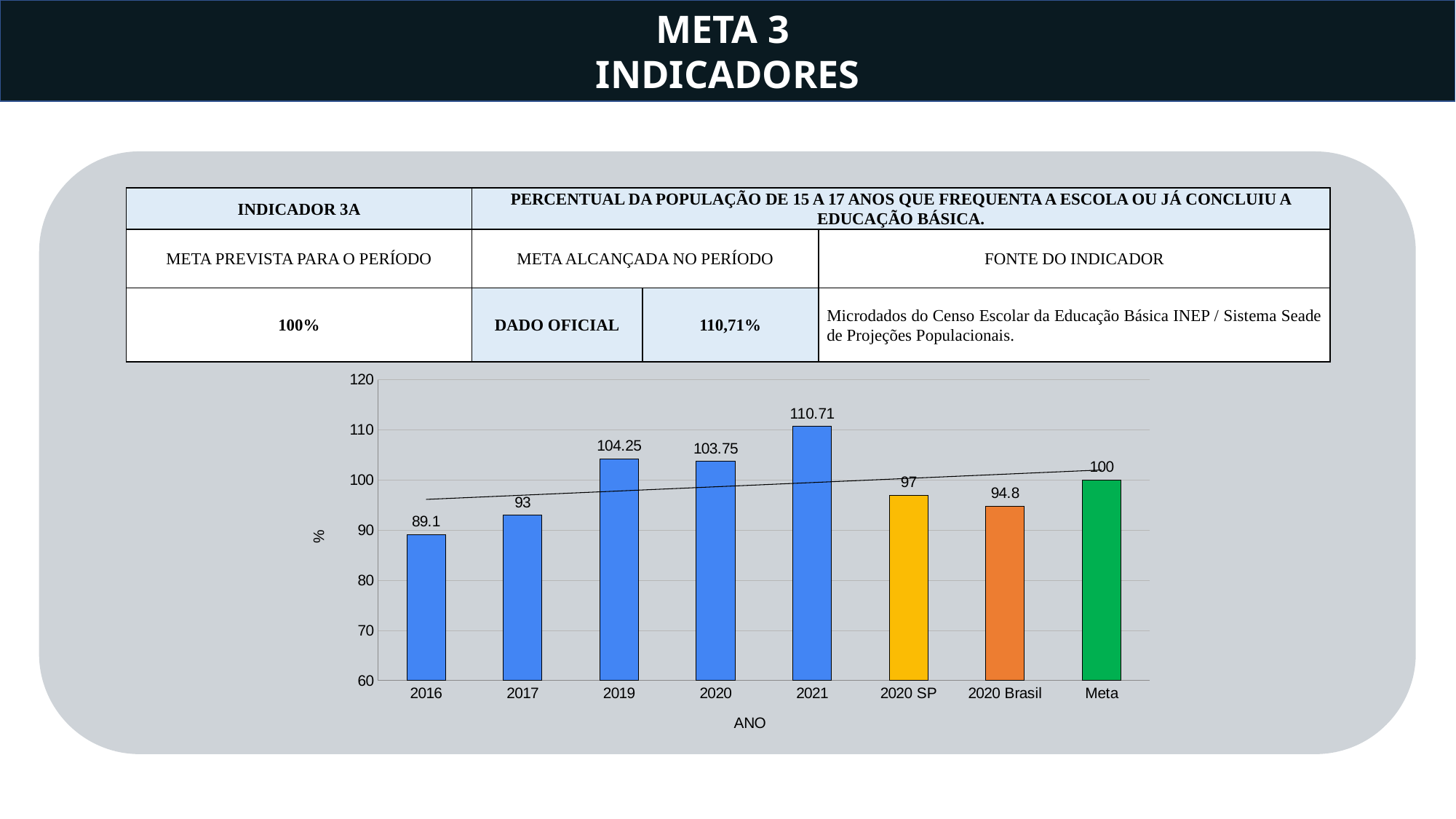
What is the value for 2016? 89.1 How many bars are shown in the chart? 8 Is the value for 2017 greater or less than 100? less Which is larger, the value for 2020 SP or the value for 2020 Brasil? 2020 SP What kind of chart is shown on the slide? bar chart What is the value for 2020 Brasil? 94.8 Which category has the highest value? 2021 What is the value for 2020 SP? 97 Which category has the lowest value? 2016 What is the difference between the values for 2019 and 2020? 0.5 What is the value for 2021? 110.71 What is the label of the x axis? ANO